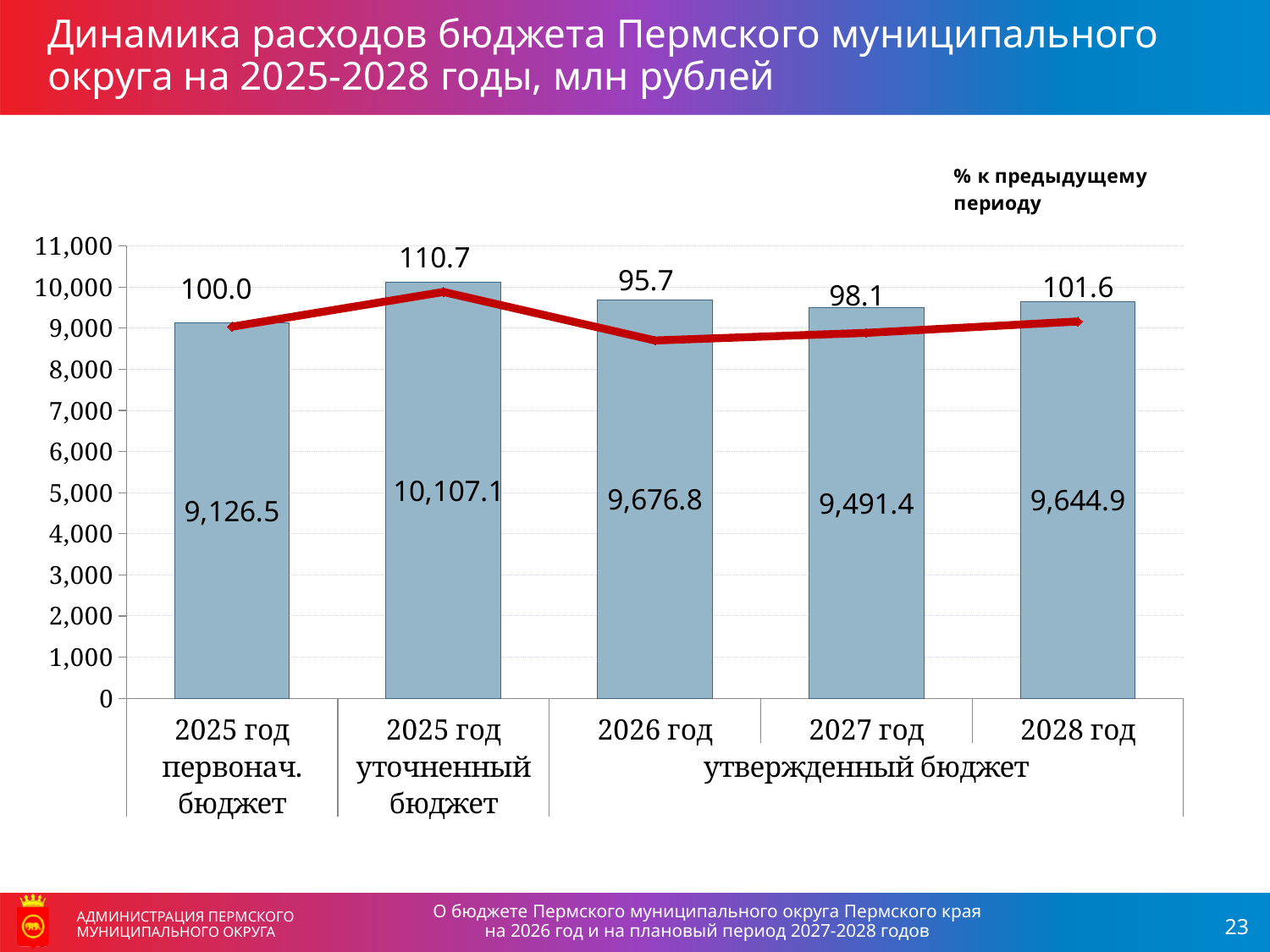
What percentage to the previous period is shown for 2025 год уточненный бюджет? 110.7 How many bars are plotted on the chart? 5 What is the difference between the bar values for 2026 год and 2027 год? 185.4 What is the value of the bar for 2025 год уточненный бюджет? 10,107.1 Which category has the lowest bar value? 2025 год первонач. бюджет Which category has the highest bar value? 2025 год уточненный бюджет Which category has the lowest percentage to the previous period on the line? 2026 год Which is larger, the bar value for 2028 год or for 2027 год? 2028 год What is the budget expenditure value shown for 2026 год? 9,676.8 What percentage to the previous period is shown for 2027 год? 98.1 What is the difference between the bar values for 2025 год уточненный бюджет and 2025 год первонач. бюджет? 980.6 What kind of chart is shown on the slide? Bar chart with a line